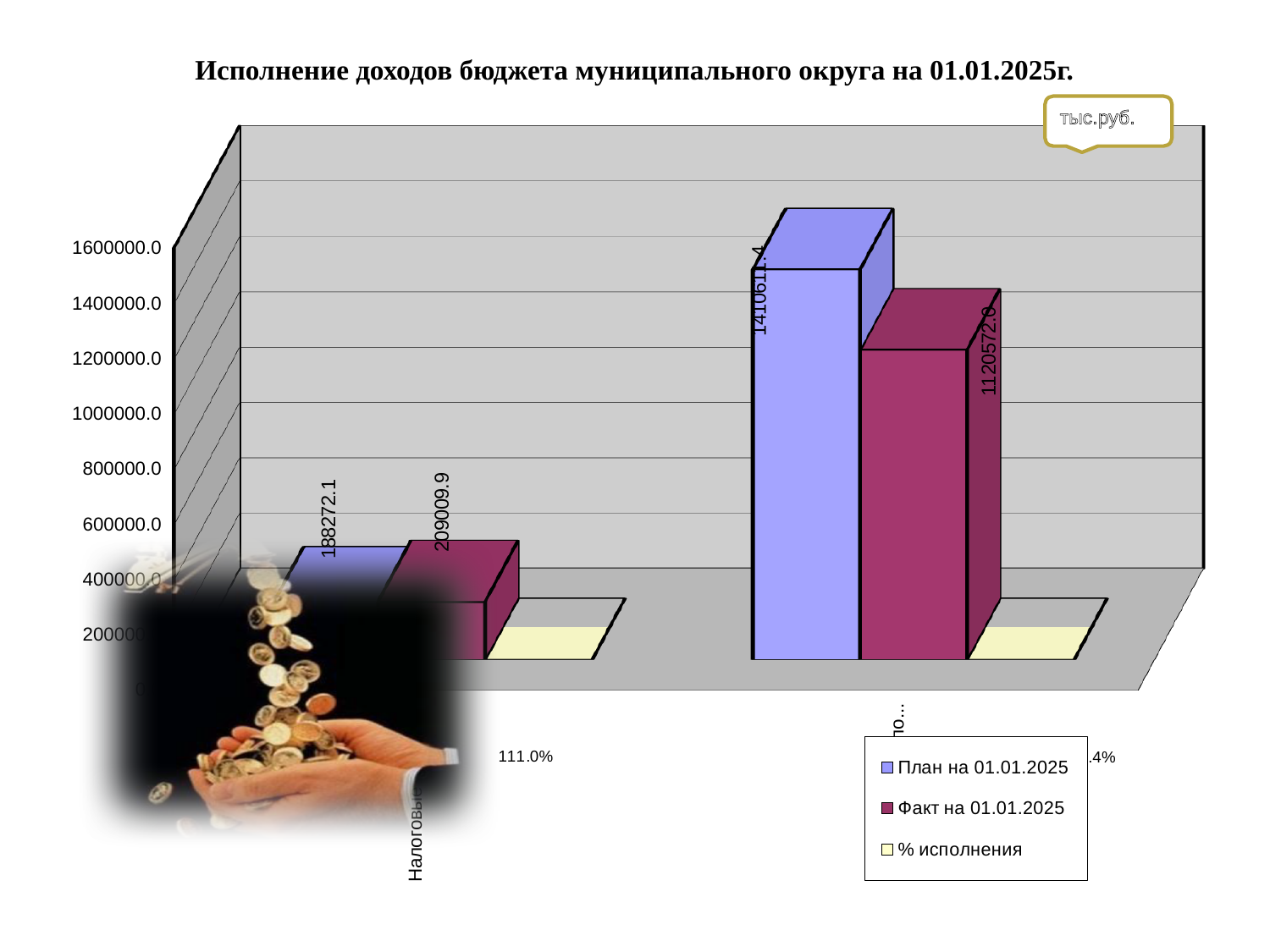
How many series does the legend list? 3 For the left-hand category (Налоговые), which is larger: 'План на 01.01.2025' or 'Факт на 01.01.2025'? Факт на 01.01.2025 What is the value of 'План на 01.01.2025' for the left-hand category (Налоговые)? 188272.1 What is the value of 'Факт на 01.01.2025' for the left-hand category (Налоговые)? 209009.9 What kind of chart is shown on the slide? bar chart What is the difference between 'Факт на 01.01.2025' and 'План на 01.01.2025' for the left-hand category (Налоговые)? 20737.8 What is the '% исполнения' value shown for the left-hand category (Налоговые)? 111.0% How many categories are plotted along the x axis? 2 What unit of measurement is indicated in the callout at the top right of the chart? тыс.руб. Is the value of 'План на 01.01.2025' for the right-hand category greater or less than 1200000.0? greater For the right-hand category, which is larger: 'План на 01.01.2025' or 'Факт на 01.01.2025'? План на 01.01.2025 Is the value of 'Факт на 01.01.2025' for the right-hand category greater or less than 1000000.0? greater